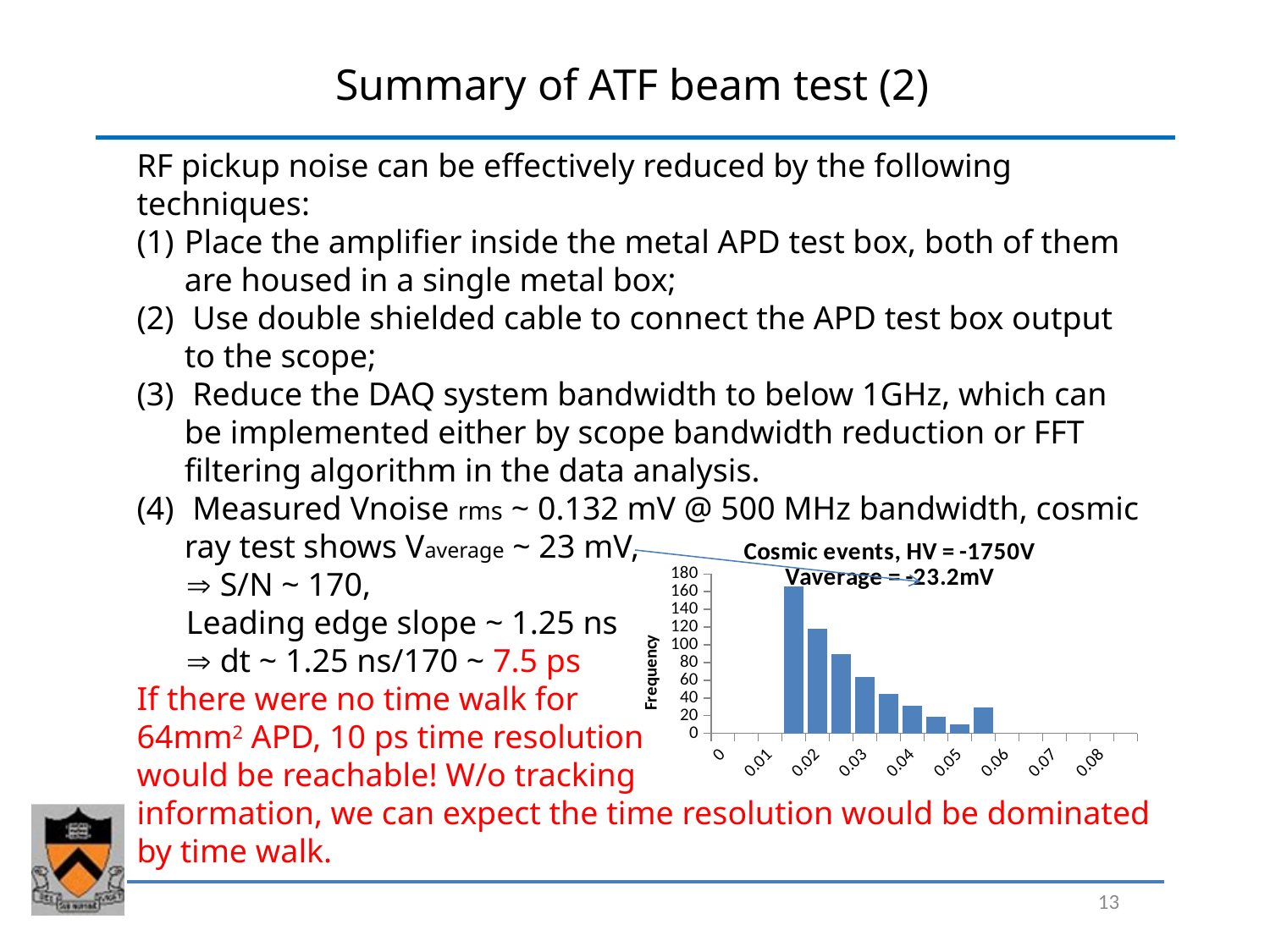
What kind of chart is shown on the slide? Bar chart Do the bar heights generally rise or fall from left to right across the chart? Fall Is the value of the rightmost bar greater or less than 40? less Which is taller, the first bar from the left or the second bar from the left? The first bar What is the title of the chart? Cosmic events, HV = -1750V Vaverage = -23.2mV Is the value of the third bar from the left greater or less than 100? less How many bars are plotted in the chart? 9 Is the value of the fourth bar from the left greater or less than 80? less What Vaverage value is printed on the chart? -23.2mV Which bar has the highest frequency? The first (leftmost) bar